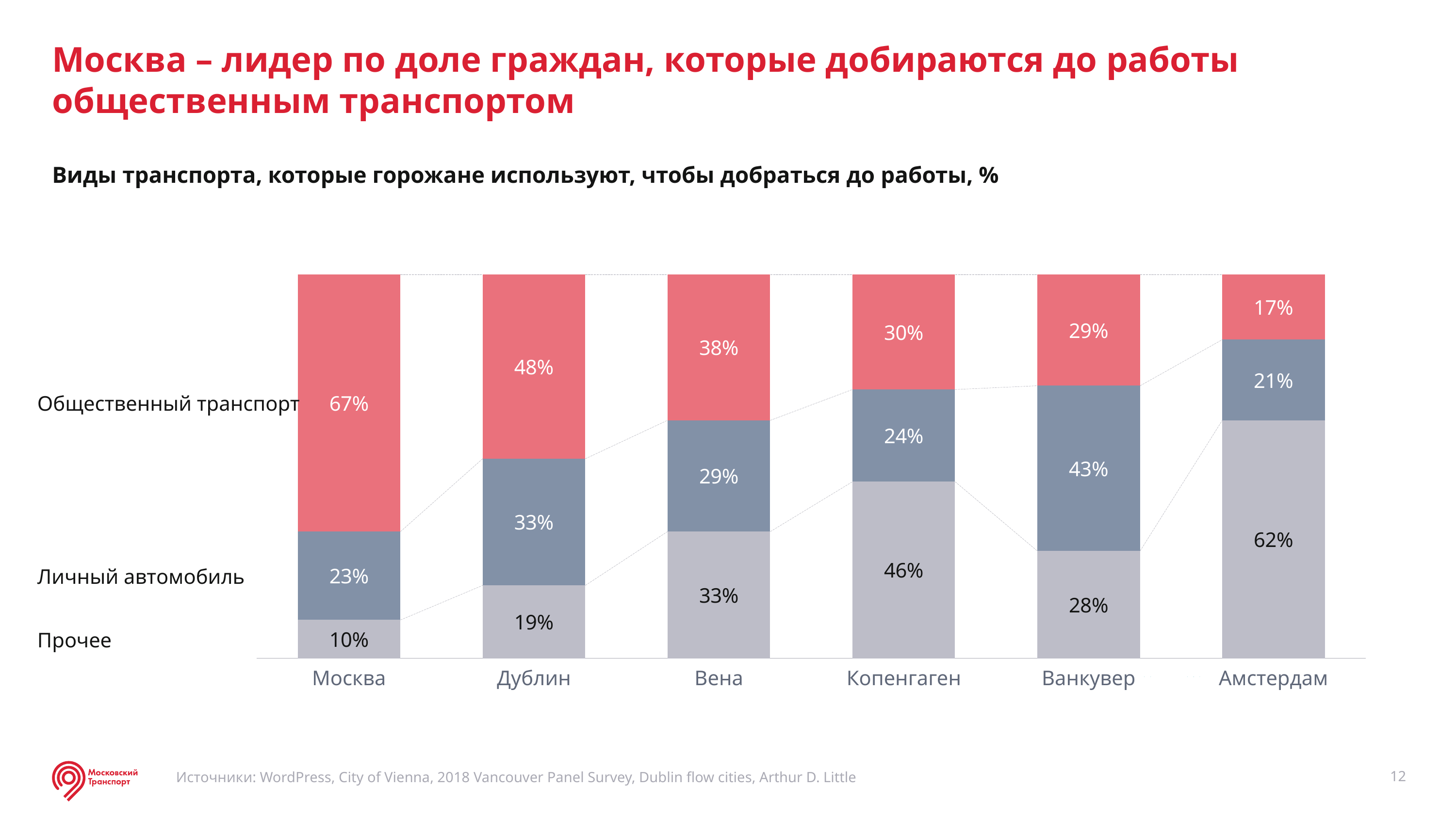
What is the difference between the Общественный транспорт shares of Москва and Дублин? 19% What is the value for Личный автомобиль in Ванкувер? 43% What is the value for Прочее in Амстердам? 62% Which city has the highest share for Общественный транспорт? Москва Which is larger: the Личный автомобиль share in Вена or in Ванкувер? Ванкувер What type of chart is shown on the slide? Stacked bar chart How many cities are shown on the x axis? 6 What is the value for Общественный транспорт in Копенгаген? 30% What share of commuters in Москва use Общественный транспорт? 67% Which city has the lowest share for Общественный транспорт? Амстердам Which city has the lowest share for Прочее? Москва How many series (transport types) does the chart show? 3